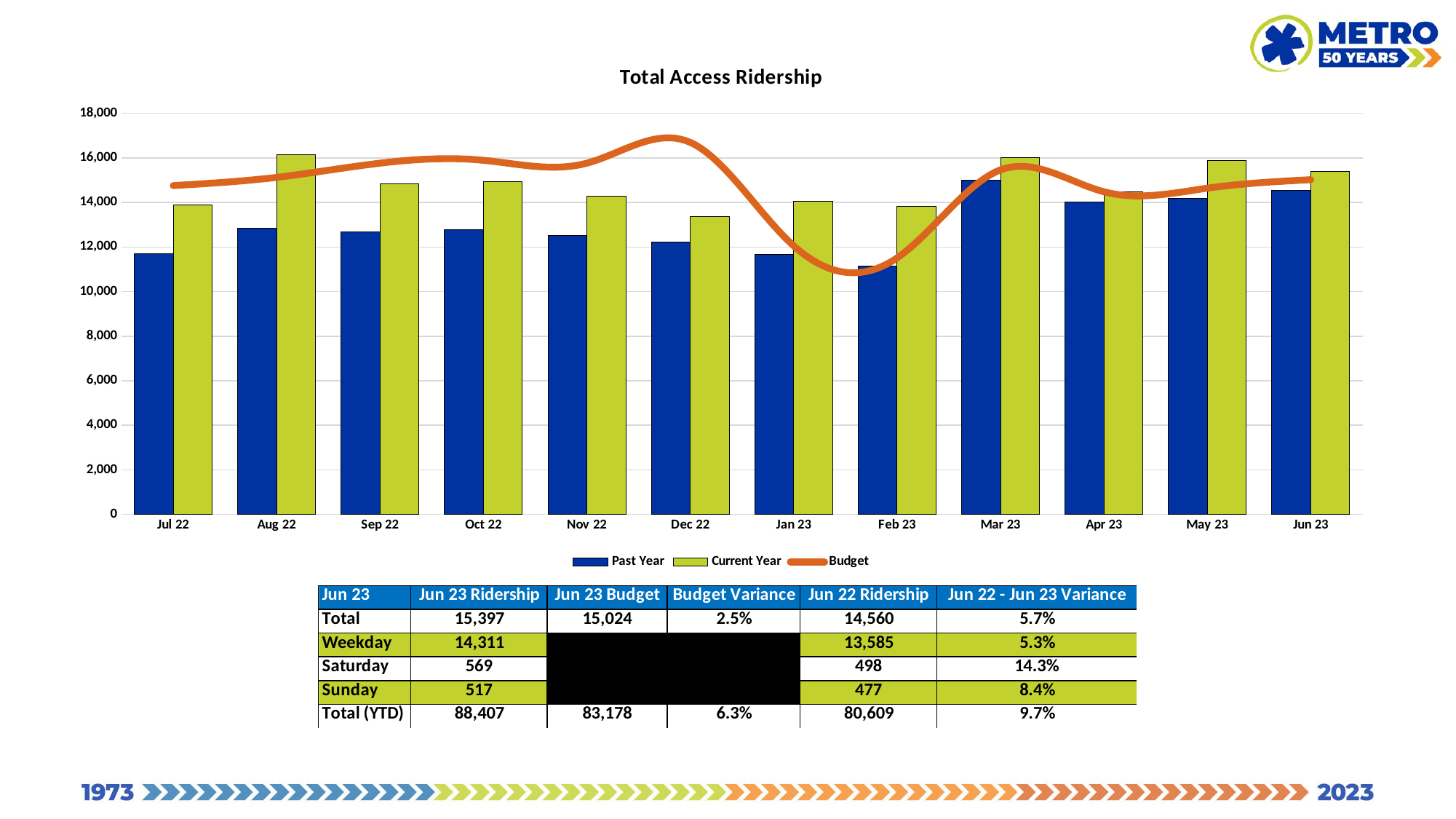
How many months are shown on the x axis? 12 According to the table, what is the Jun 23 Current Year ridership total? 15,397 Is the Past Year value for Jul 22 greater or less than 12,000? less Does the Past Year series rise or fall from Feb 23 to Mar 23? rise What kind of chart is shown on the slide? bar chart with a line What is the title of the chart? Total Access Ridership Which month has the lowest Current Year bar? Dec 22 Is the Budget value for Dec 22 greater or less than 16,000? greater Which month has the highest Past Year bar? Mar 23 In Dec 22, which is larger: the Budget line or the Current Year bar? Budget How many series does the legend list? 3